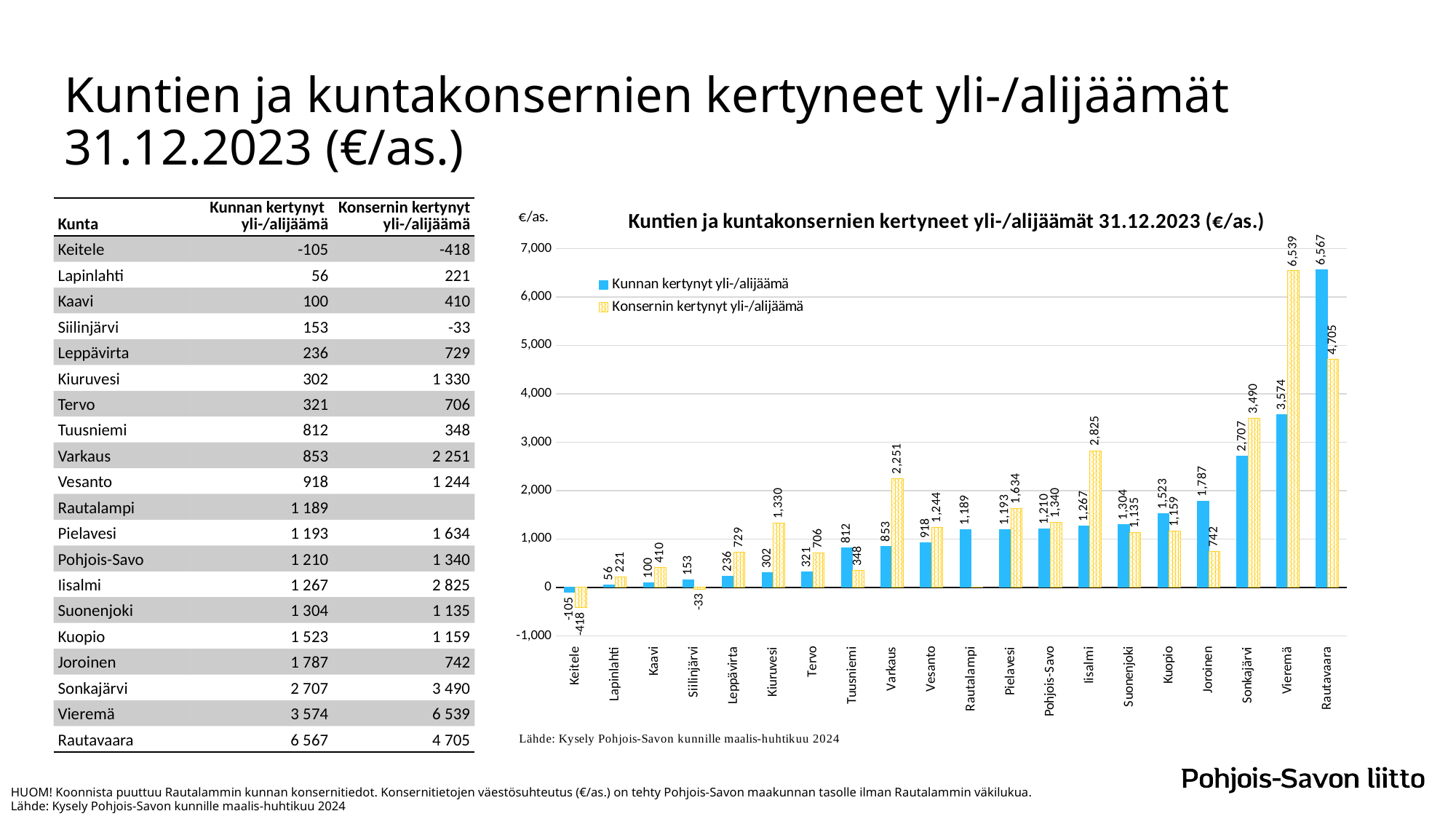
Is the value of Konsernin kertynyt yli-/alijäämä for Sonkajärvi greater or less than 3,000? greater What colour are the bars for Kunnan kertynyt yli-/alijäämä in the chart? blue What is the value of Konsernin kertynyt yli-/alijäämä for Iisalmi? 2,825 How many series does the chart legend list? 2 Which municipality has the lowest value for Konsernin kertynyt yli-/alijäämä? Keitele What is the difference between the Konsernin and Kunnan kertynyt yli-/alijäämä values for Vieremä? 2,965 How many municipalities are shown on the x axis of the chart? 20 Which municipality has the highest value for Kunnan kertynyt yli-/alijäämä? Rautavaara What is the value of Konsernin kertynyt yli-/alijäämä for Siilinjärvi? -33 What is the value of Kunnan kertynyt yli-/alijäämä for Vieremä? 3,574 What type of chart is shown on the slide? bar chart For Joroinen, which is larger: Kunnan kertynyt yli-/alijäämä or Konsernin kertynyt yli-/alijäämä? Kunnan kertynyt yli-/alijäämä